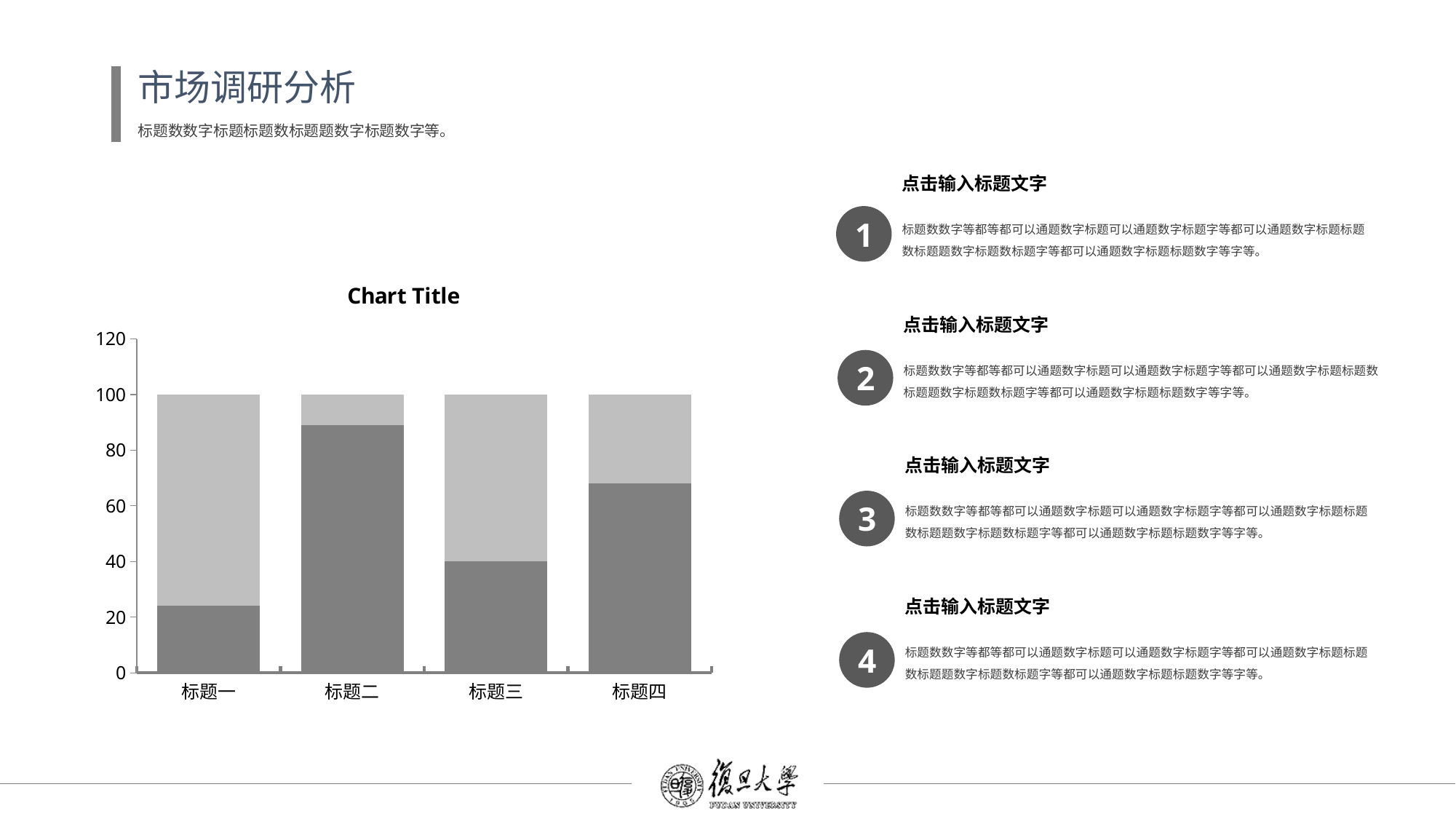
Is the dark grey (bottom) segment for 标题一 greater or less than 40? less Which has the larger dark grey (bottom) segment, 标题二 or 标题三? 标题二 How many categories are shown on the x axis of the chart? 4 What is the title of the chart? Chart Title Is the dark grey (bottom) segment for 标题四 greater or less than 60? greater What is the total height of the stacked bar for 标题一? 100 Is the dark grey (bottom) segment for 标题二 greater or less than 80? greater Which category has the largest dark grey (bottom) segment? 标题二 What is the total height of the stacked bar for 标题四? 100 Which has the larger light grey (top) segment, 标题一 or 标题四? 标题一 Which category has the smallest dark grey (bottom) segment? 标题一 What kind of chart is shown on the slide? bar chart